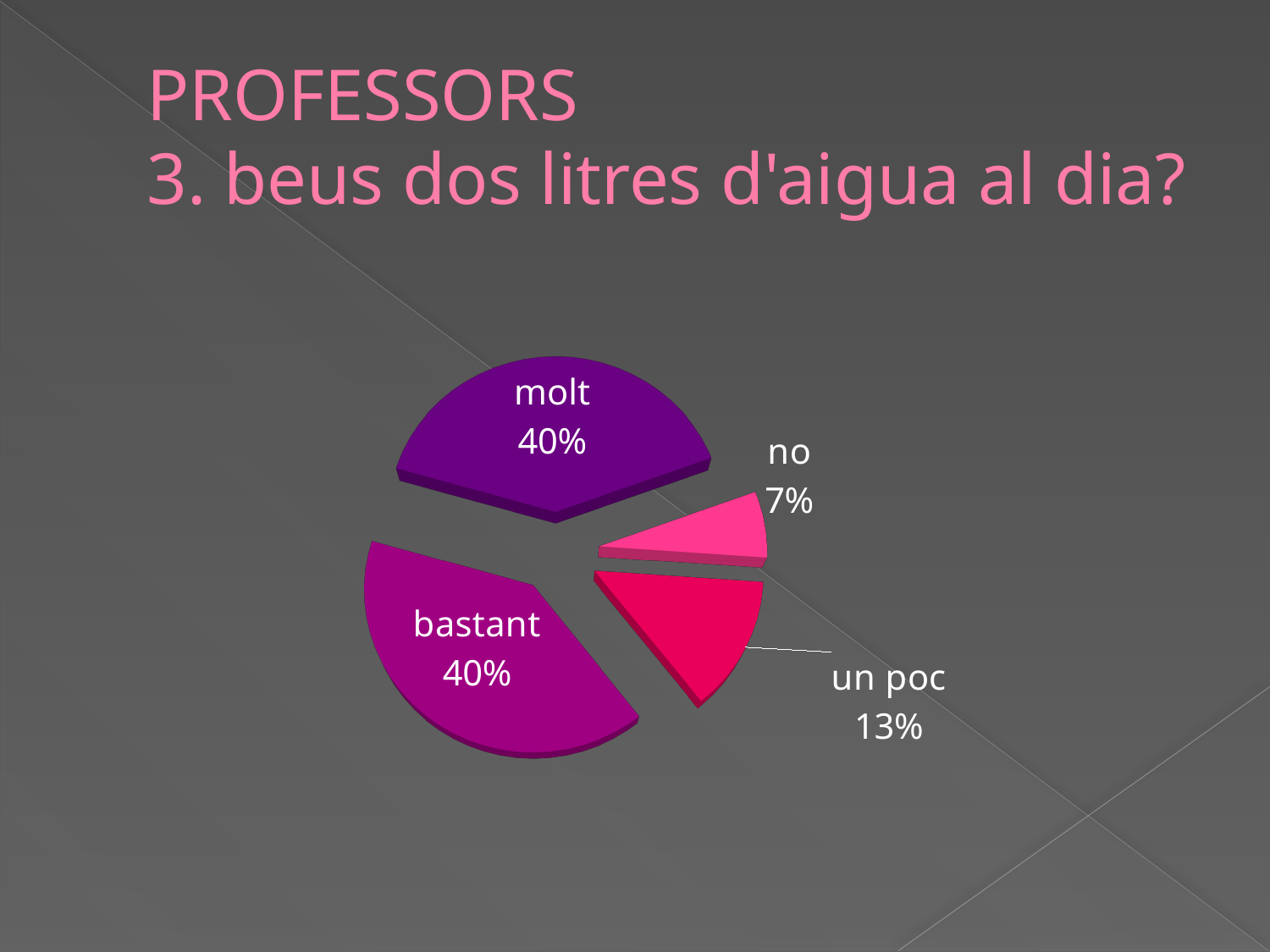
Which slice of the pie chart is the smallest? no What percentage is shown for the "un poc" slice? 13% What kind of chart is shown on the slide? pie chart What question is the pie chart about, according to the slide title? 3. beus dos litres d'aigua al dia? What is the difference in percentage points between the "un poc" slice and the "no" slice? 6% What is the difference in percentage points between the "bastant" slice and the "un poc" slice? 27% What percentage is shown for the "bastant" slice? 40% Which slice is larger, "un poc" or "no"? un poc Which slice is larger, "molt" or "un poc"? molt What percentage is shown for the "molt" slice? 40% How many slices does the pie chart have? 4 What percentage is shown for the "no" slice? 7%